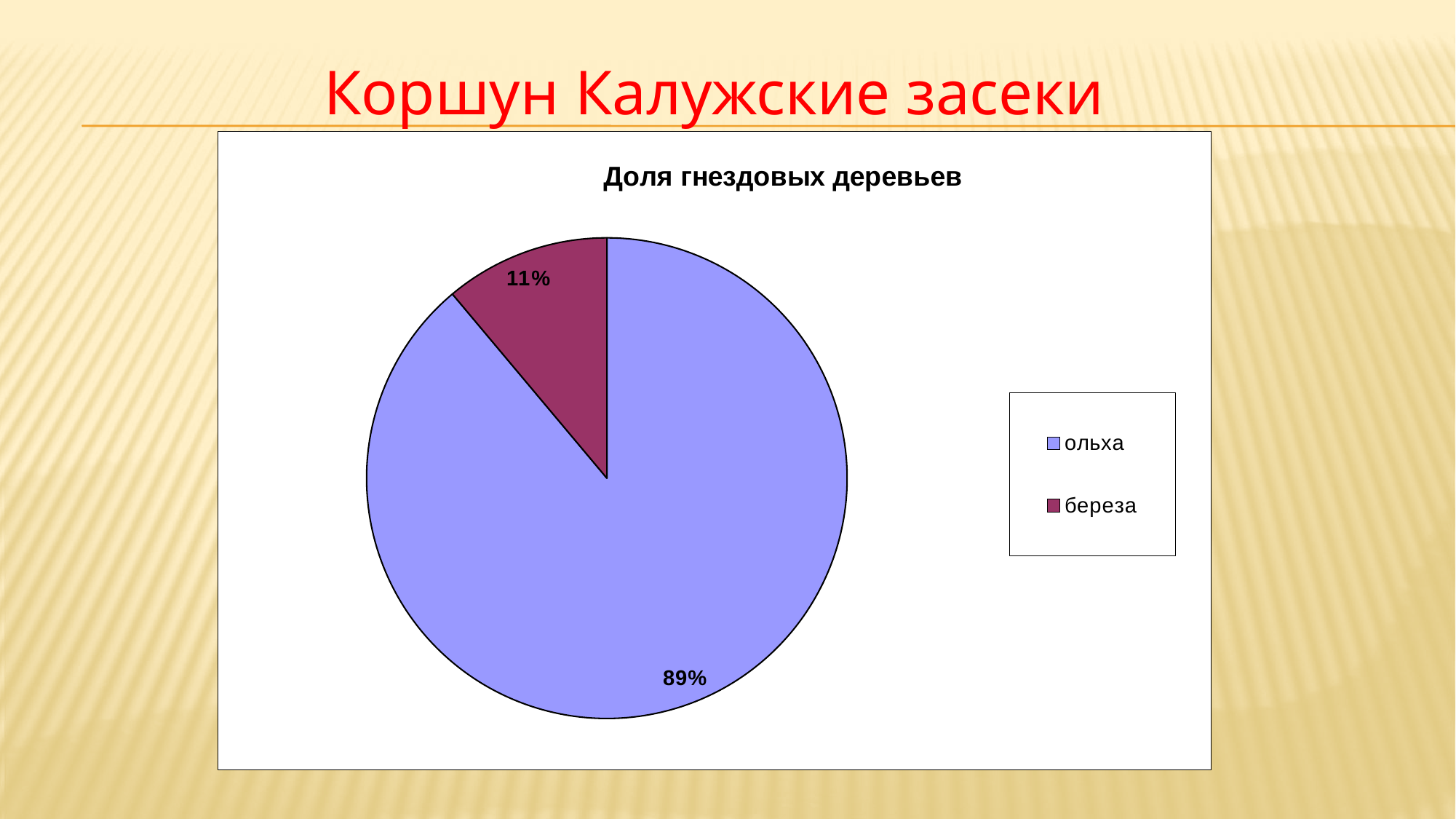
What colour is the slice for береза? dark red What is the difference in percentage points between the ольха and береза slices? 78 What share of the pie does береза have? 11% Which category has the smallest slice of the pie? береза How many entries does the legend list? 2 Which category has the largest slice of the pie? ольха Which slice is larger, ольха or береза? ольха What kind of chart is shown on the slide? pie chart What is the title of the chart? Доля гнездовых деревьев What share of the pie does ольха have? 89% How many slices does the pie chart have? 2